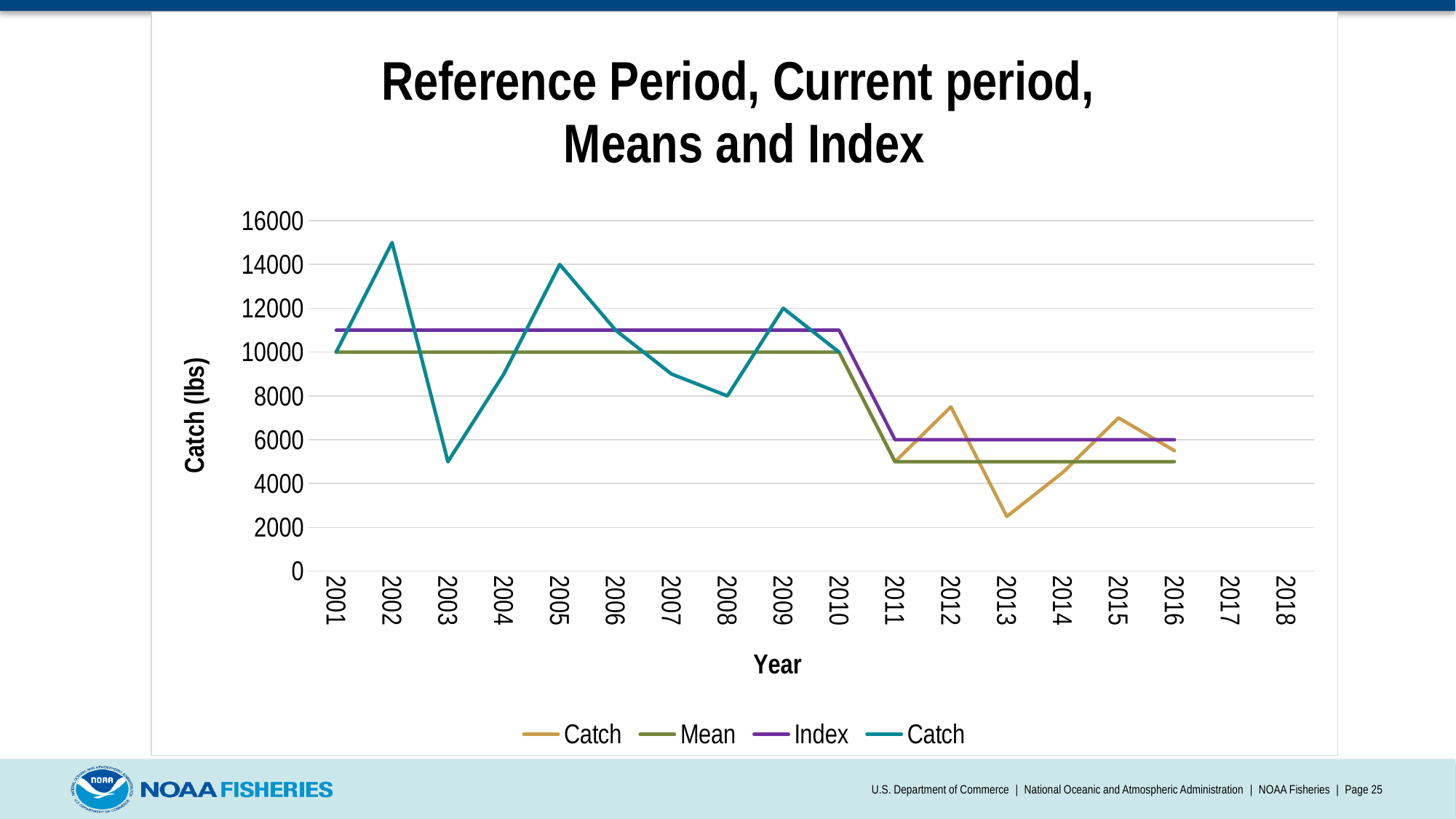
Does the Index series rise or fall between 2010 and 2011? fall Is the value of the teal Catch series in 2003 greater or less than 6000? less What is the value of the teal Catch series in 2005? 14000 In which year does the orange Catch series reach its lowest value? 2013 In which year does the teal Catch series reach its highest value? 2002 How many series does the legend list? 4 What is the value of the Index series in 2011? 6000 How many year labels are shown on the x axis? 18 What is the label on the vertical axis? Catch (lbs) What is the value of the Mean series in 2001? 10000 What is the title of the chart? Reference Period, Current period, Means and Index What kind of chart is shown on the slide? line chart